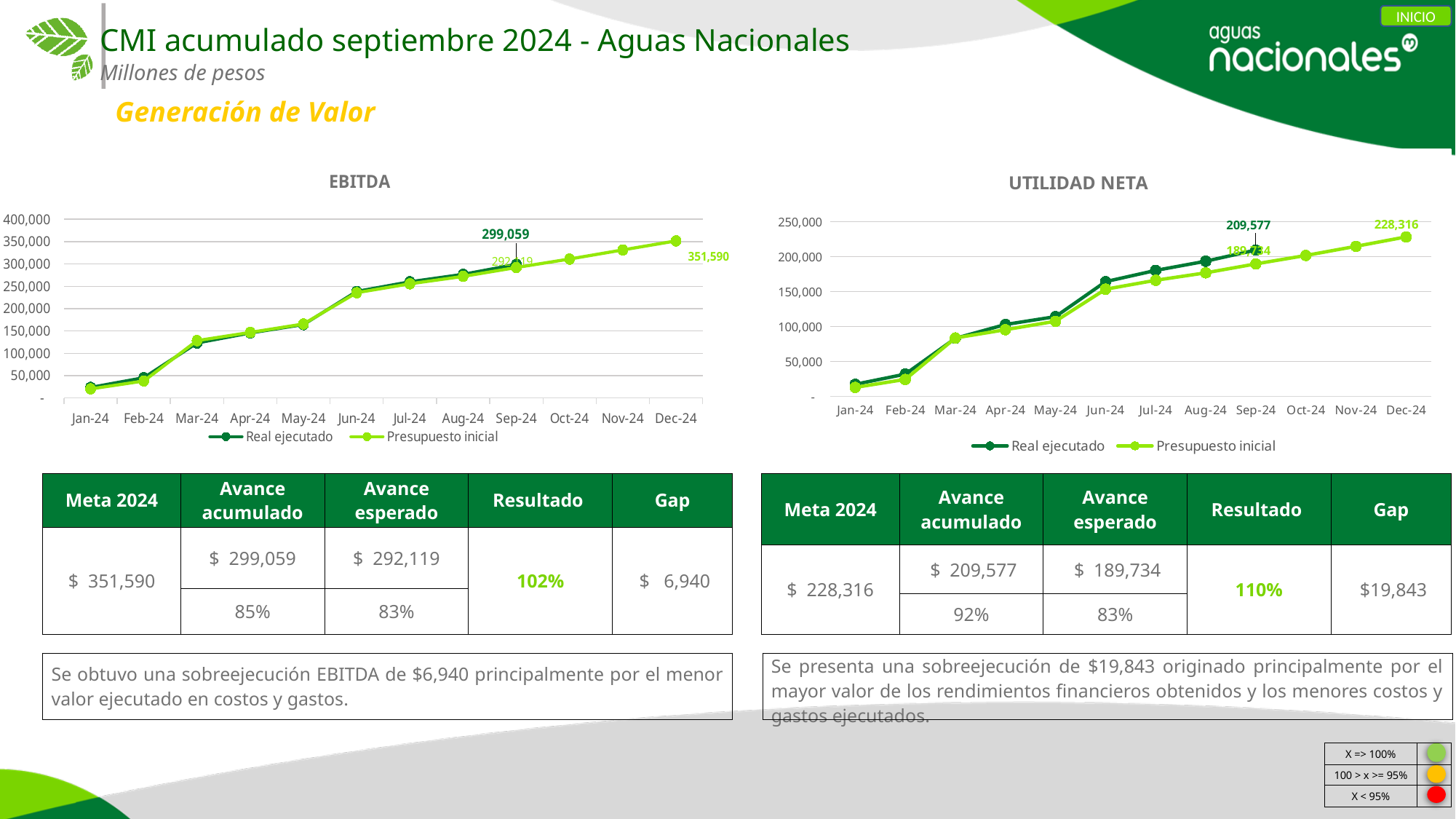
In the EBITDA chart, is the value of Presupuesto inicial at Jan-24 greater or less than 50,000? less In the UTILIDAD NETA chart, what is the difference between Real ejecutado and Presupuesto inicial at Sep-24? 19,843 In the UTILIDAD NETA chart, what is the value of Real ejecutado at Sep-24? 209,577 In the EBITDA chart, what is the value of Presupuesto inicial at Dec-24? 351,590 How many months are plotted along the x axis of the EBITDA chart? 12 In the UTILIDAD NETA chart, which series is higher at Aug-24, Real ejecutado or Presupuesto inicial? Real ejecutado How many series does the legend of the UTILIDAD NETA chart list? 2 In the UTILIDAD NETA chart, what is the value of Presupuesto inicial at Dec-24? 228,316 In the EBITDA chart, what is the value of Real ejecutado at Sep-24? 299,059 In the EBITDA chart, what is the difference between Real ejecutado and Presupuesto inicial at Sep-24? 6,940 In the UTILIDAD NETA chart, do the Presupuesto inicial values rise or fall from Jan-24 to Dec-24? rise What kind of chart is the EBITDA chart? line chart